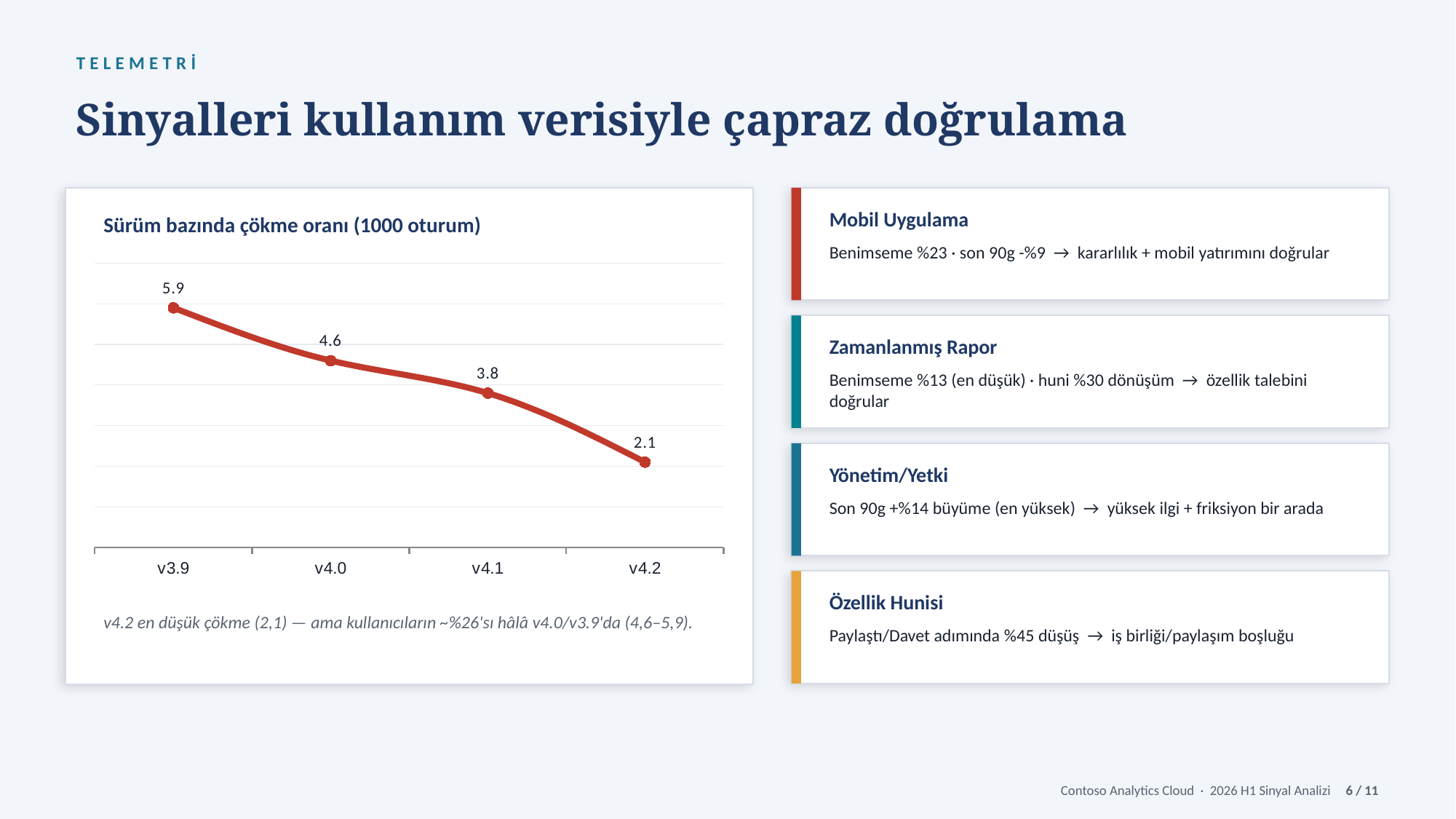
What is the difference between the crash rate for v3.9 and v4.2? 3.8 How many versions are plotted on the chart? 4 What is the crash rate value for v3.9? 5.9 What is the difference between the crash rate for v4.0 and v4.1? 0.8 Which version has the lowest crash rate? v4.2 What kind of chart is shown on the slide? Line chart What is the crash rate value for v4.1? 3.8 Which has a higher crash rate, v4.0 or v4.1? v4.0 What is the crash rate value for v4.2? 2.1 Which version has the highest crash rate? v3.9 What is the crash rate value for v4.0? 4.6 Does the crash rate rise or fall from v3.9 to v4.2? Fall